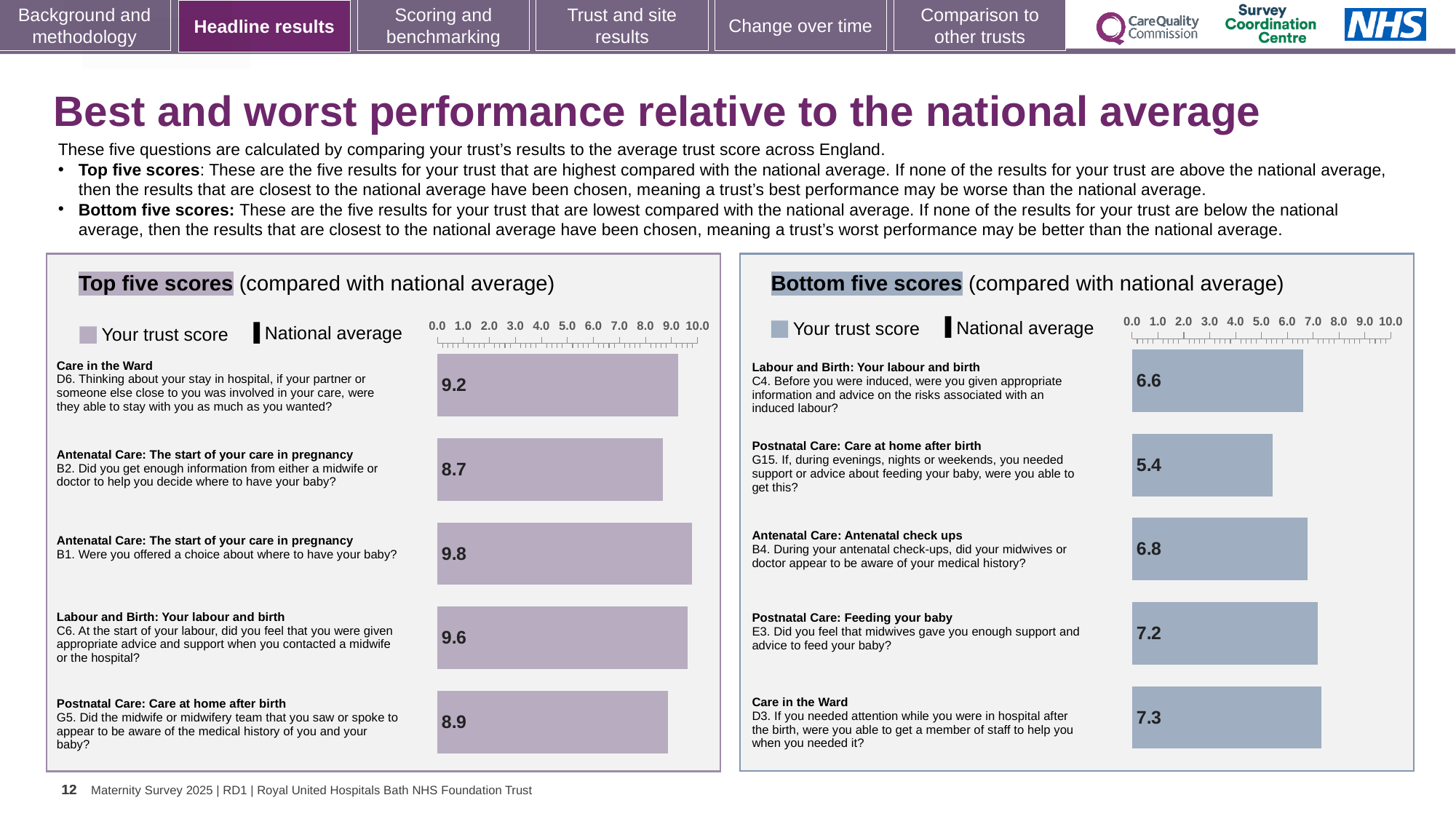
In the Top five scores chart, what is the difference between the scores for B1 and B2? 1.1 What two entries does the legend of the Top five scores chart list? Your trust score and National average In the Bottom five scores chart, which question has the highest trust score? D3. If you needed attention while you were in hospital after the birth, were you able to get a member of staff to help you when you needed it? In the Top five scores chart, which question has the highest trust score? B1. Were you offered a choice about where to have your baby? In the Bottom five scores chart, which has the larger score: C4 or B4? B4 In the Top five scores chart, which question has the lowest trust score? B2. Did you get enough information from either a midwife or doctor to help you decide where to have your baby? What type of chart is used for the Bottom five scores? Bar chart In the Bottom five scores chart, what is the trust score for G15 (support or advice about feeding your baby during evenings, nights or weekends)? 5.4 In the Top five scores chart, what is the trust score for D6 (partner able to stay with you as much as you wanted)? 9.2 In the Bottom five scores chart, which question has the lowest trust score? G15. If, during evenings, nights or weekends, you needed support or advice about feeding your baby, were you able to get this? In the Bottom five scores chart, what is the difference between the scores for D3 and G15? 1.9 How many bars are shown in the Top five scores chart? 5